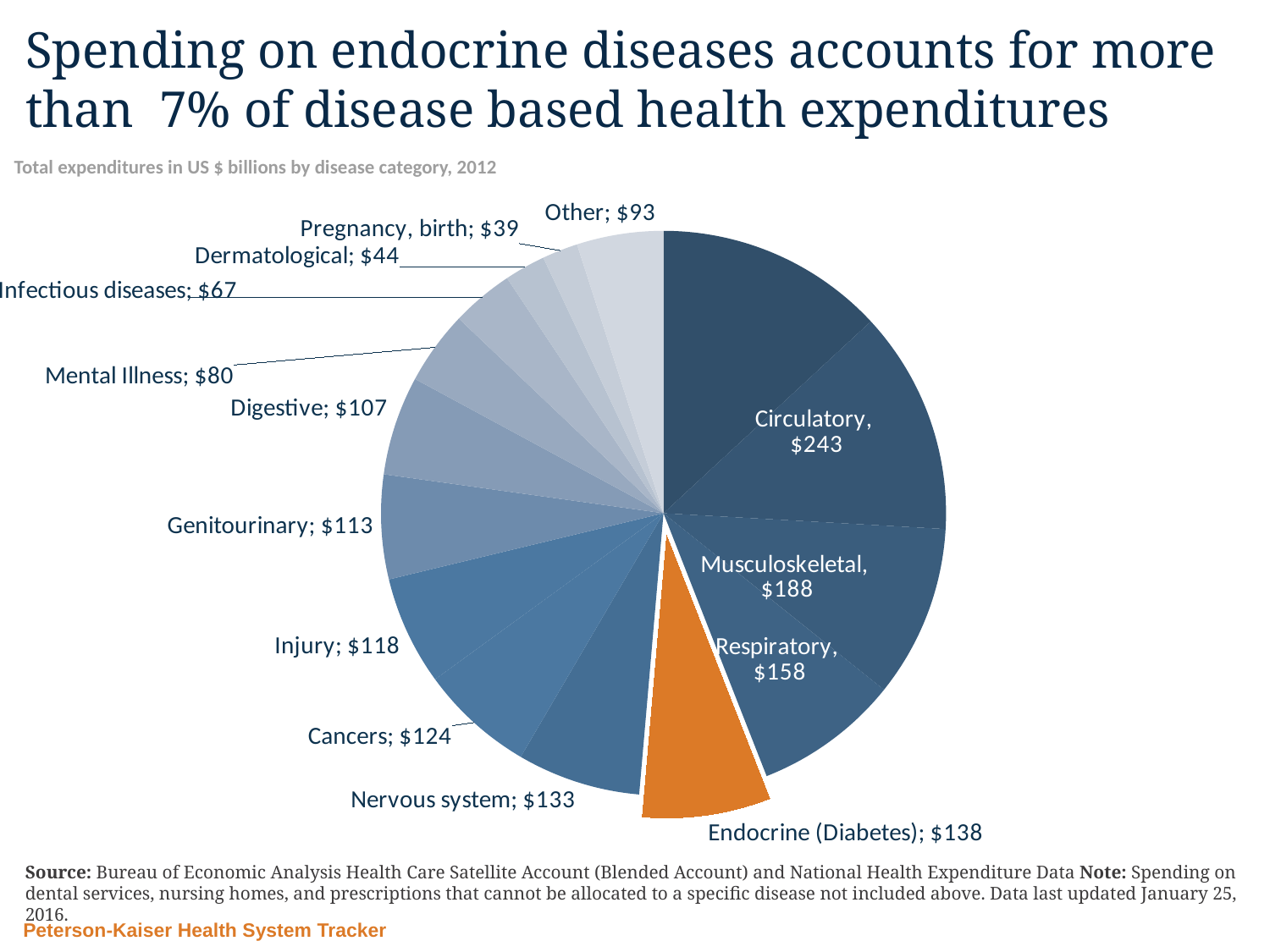
What is the value for Pregnancy, birth? $39 What is the value for Endocrine (Diabetes)? $138 What is the value for Genitourinary? $113 What kind of chart is shown on the slide? pie chart Which is larger, spending on Injury or on Genitourinary? Injury How many disease categories are shown in the pie chart? 15 What is the value for Circulatory? $243 What is the difference between Circulatory and Musculoskeletal spending? $55 What is the difference between Other and Mental Illness spending? $13 Which disease category has the lowest spending? Pregnancy, birth Which slice of the pie chart is highlighted in orange? Endocrine (Diabetes)